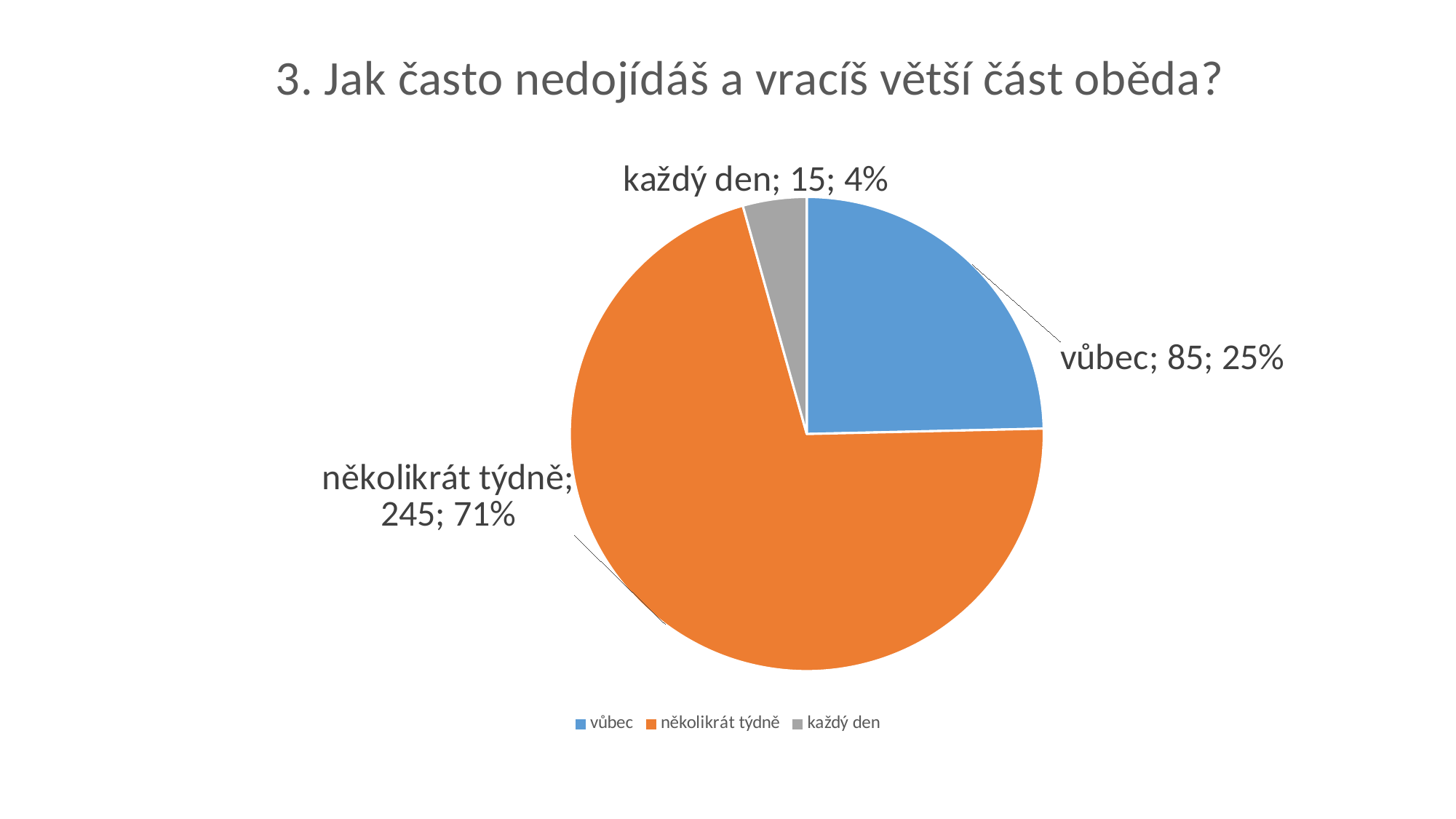
What is the count for "několikrát týdně"? 245 Which is larger, the count for "vůbec" or for "každý den"? vůbec What is the title of the chart? 3. Jak často nedojídáš a vracíš větší část oběda? What share of the pie does "každý den" represent? 4% How many categories does the pie chart have? 3 What is the count for "každý den"? 15 What is the difference between the counts for "několikrát týdně" and "vůbec"? 160 What share of the pie does "vůbec" represent? 25% What is the count for "vůbec"? 85 Which category has the largest slice? několikrát týdně What kind of chart is shown on the slide? pie chart Which category has the smallest slice? každý den